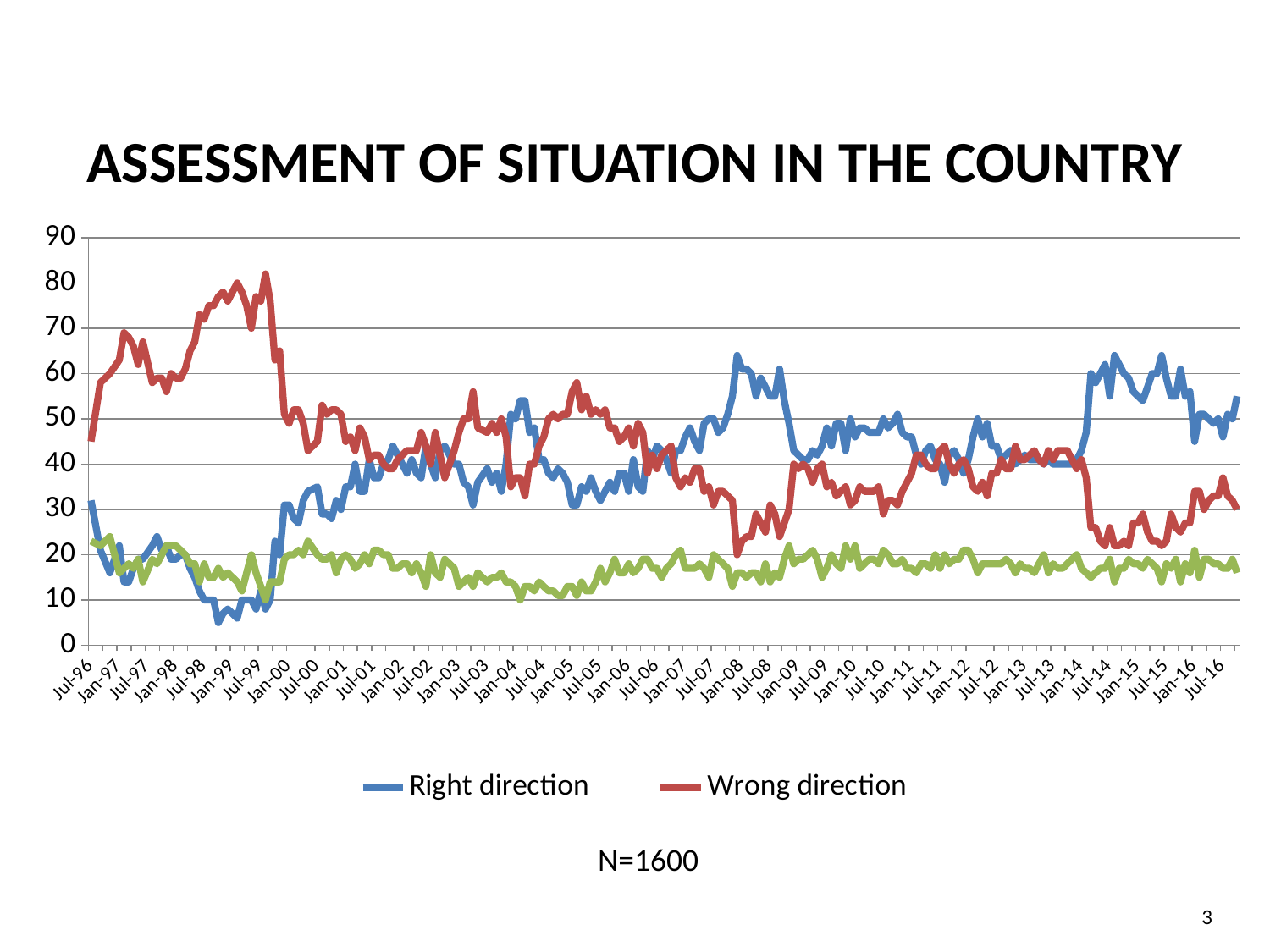
Is the value for Wrong direction around Jul-99 greater or less than 70? greater Is the value for Right direction around Jan-08 greater or less than 50? greater Around Jan-08, which is larger: Right direction or Wrong direction? Right direction What is the title of the chart? ASSESSMENT OF SITUATION IN THE COUNTRY Around Jul-99, which is larger: Right direction or Wrong direction? Wrong direction How many series does the legend list? 2 Is the value for Wrong direction around Jan-15 greater or less than 30? less What kind of chart is shown on the slide? Line chart What colour is the Right direction line? Blue Does the Wrong direction line rise or fall between Jan-14 and Jul-14? Fall Around Jul-14, which is larger: Right direction or Wrong direction? Right direction